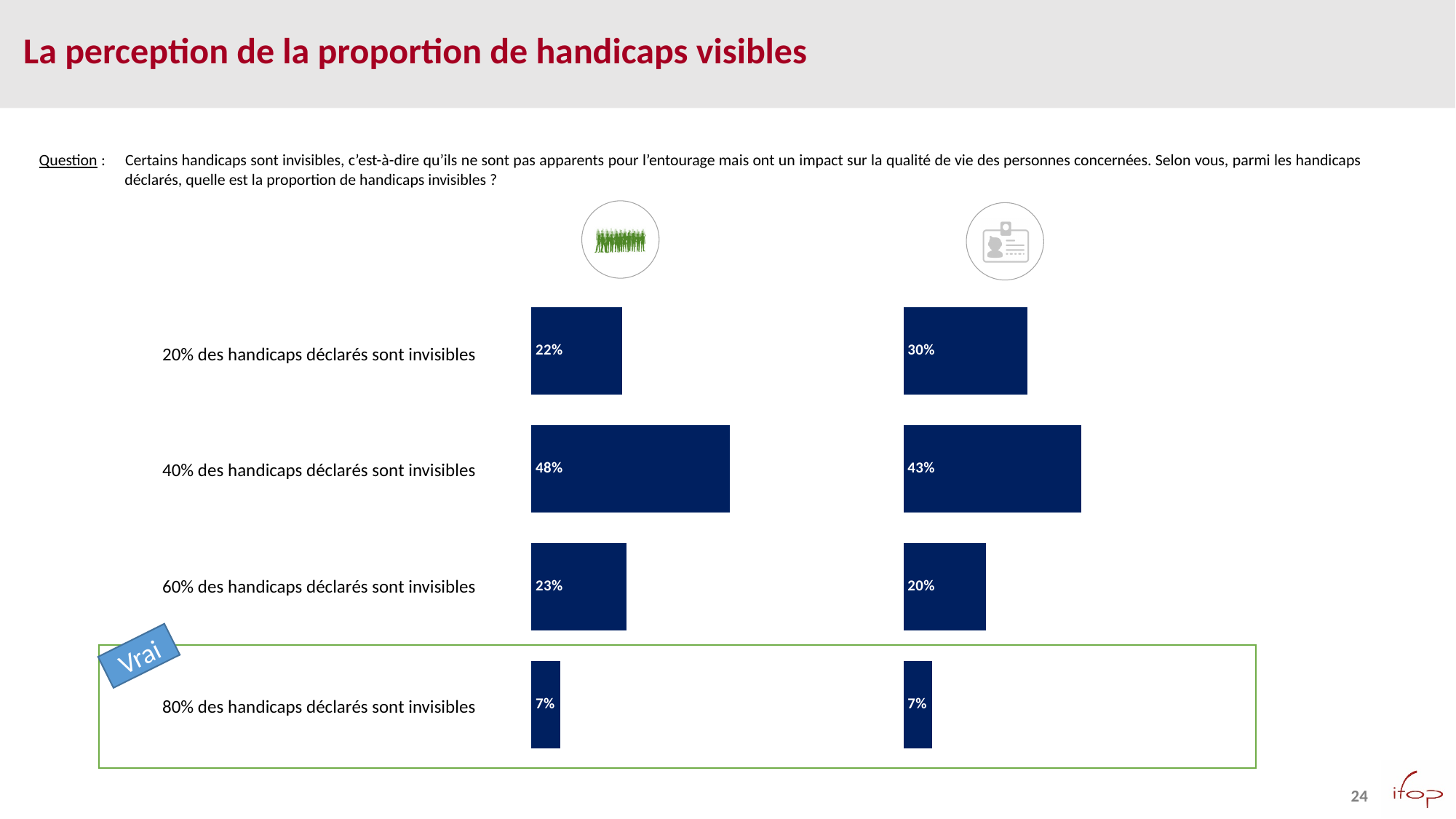
For "20% des handicaps déclarés sont invisibles", which chart shows the larger value, the left chart or the right chart? right chart How many categories does the left chart show? 4 Which category is marked with the "Vrai" label on the slide? 80% des handicaps déclarés sont invisibles In the right chart, what is the difference between the values for "20% des handicaps déclarés sont invisibles" and "60% des handicaps déclarés sont invisibles"? 10% In the left chart, what is the difference between the values for "40% des handicaps déclarés sont invisibles" and "20% des handicaps déclarés sont invisibles"? 26% In the left chart, which category has the highest value? 40% des handicaps déclarés sont invisibles What type of chart is used on this slide? bar chart In the left chart, what is the value for "80% des handicaps déclarés sont invisibles"? 7% In the right chart, what is the value for "20% des handicaps déclarés sont invisibles"? 30% In the right chart, which category has the lowest value? 80% des handicaps déclarés sont invisibles In the left chart, what is the value for "40% des handicaps déclarés sont invisibles"? 48% In the right chart, what is the value for "60% des handicaps déclarés sont invisibles"? 20%